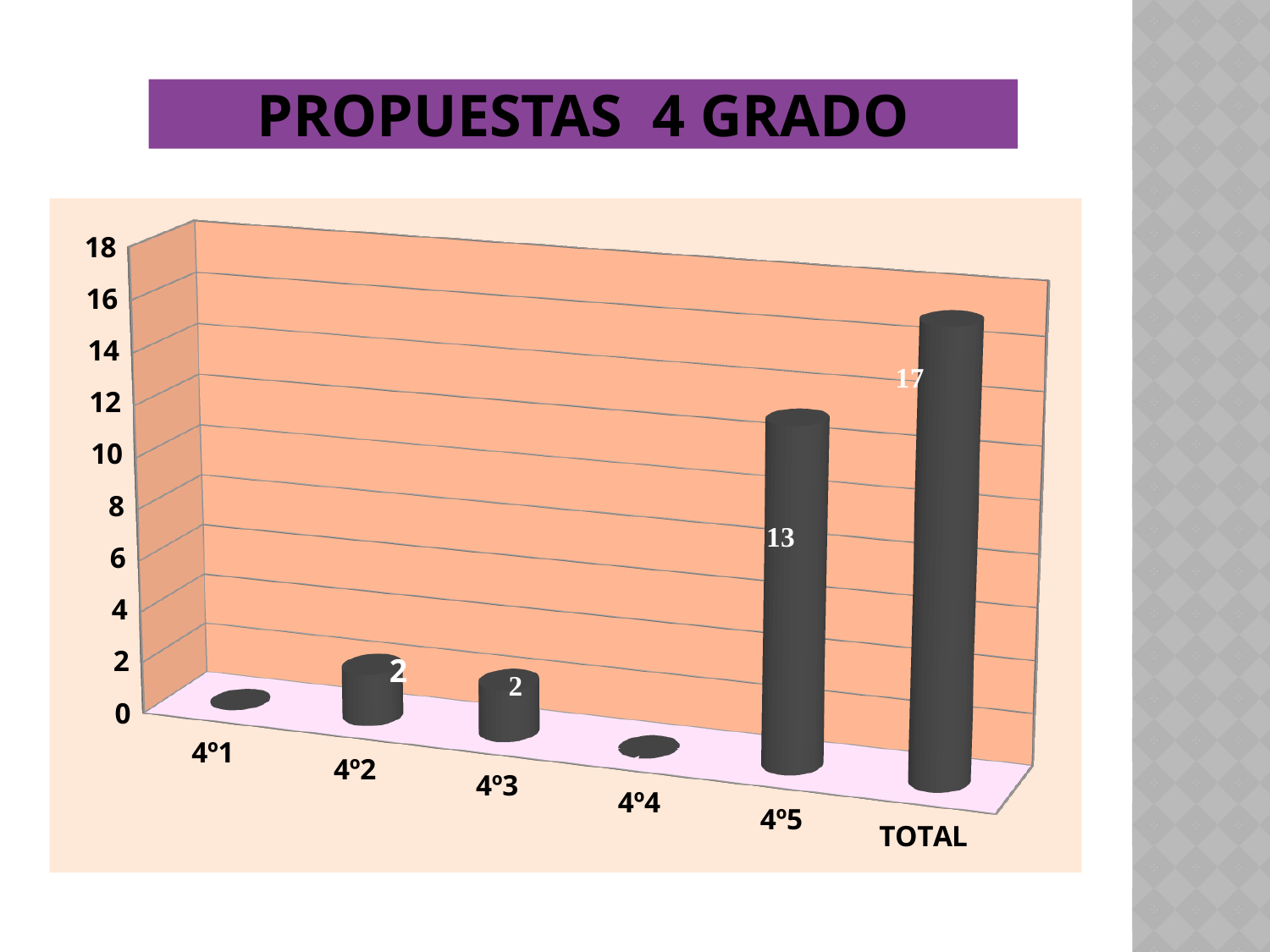
What kind of chart is shown on the slide? bar chart Which category has the highest value? TOTAL What is the value for 4º5? 13 What is the title of the chart? PROPUESTAS 4 GRADO How many categories are shown on the x axis? 6 What is the difference between the values for TOTAL and 4º5? 4 Is the value for 4º1 greater or less than 2? less What is the value for 4º3? 2 Which is larger, the value for 4º5 or the value for 4º2? 4º5 What is the value for 4º2? 2 What is the difference between the values for 4º5 and 4º3? 11 What is the value for TOTAL? 17